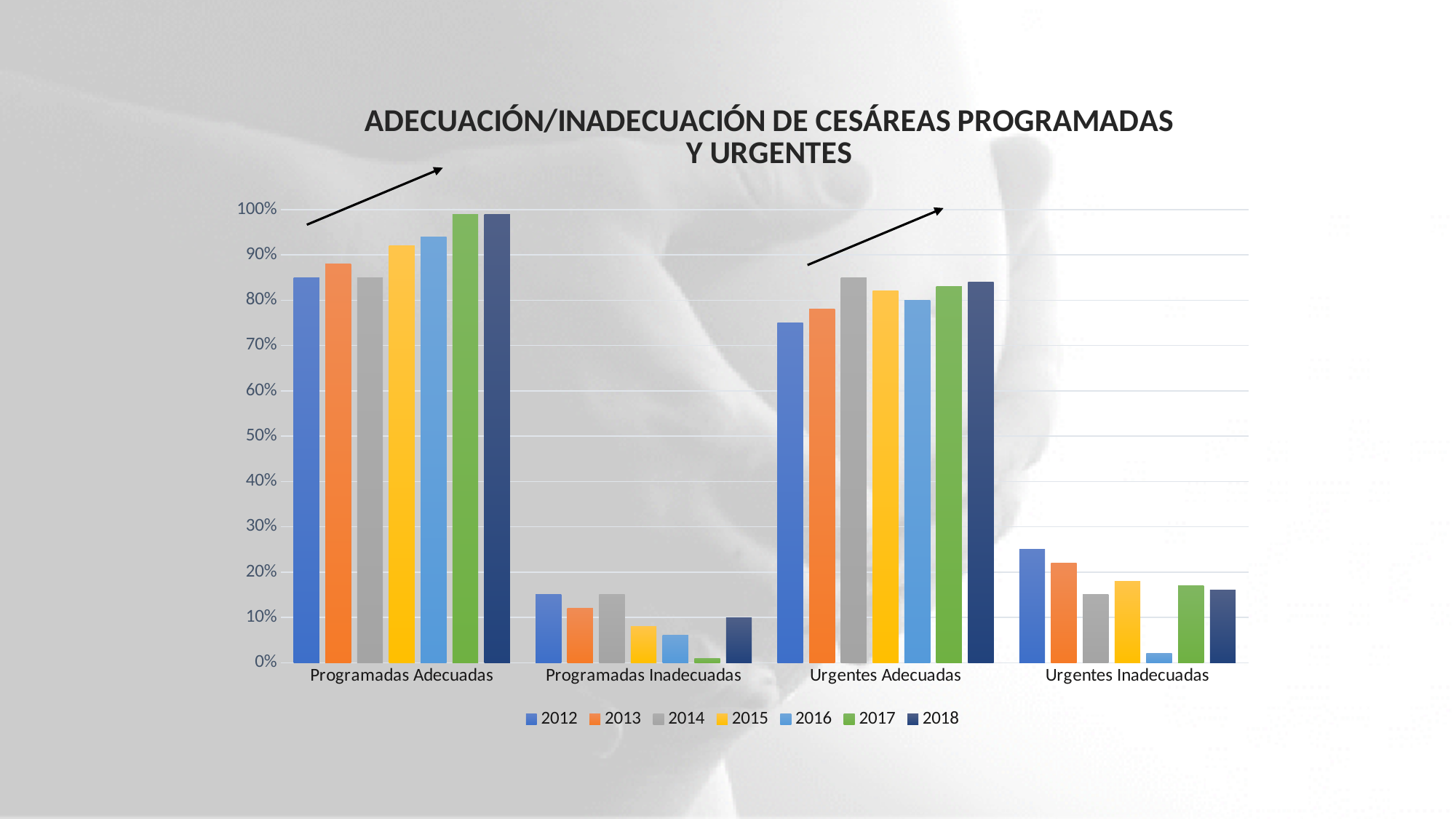
Is the value for 2017 in Programadas Inadecuadas greater or less than 10%? less Is the value for 2012 in Urgentes Adecuadas greater or less than 80%? less What is the title of the chart? ADECUACIÓN/INADECUACIÓN DE CESÁREAS PROGRAMADAS Y URGENTES Is the value for 2016 in Urgentes Inadecuadas greater or less than 10%? less Within Programadas Inadecuadas, which year has the lowest value? 2017 What kind of chart is shown on the slide? bar chart How many categories are shown on the x axis? 4 Within Urgentes Inadecuadas, which year has the lowest value? 2016 How many series does the legend list? 7 Which is larger for 2012: Programadas Adecuadas or Urgentes Adecuadas? Programadas Adecuadas Within Programadas Inadecuadas, which is larger: 2016 or 2018? 2018